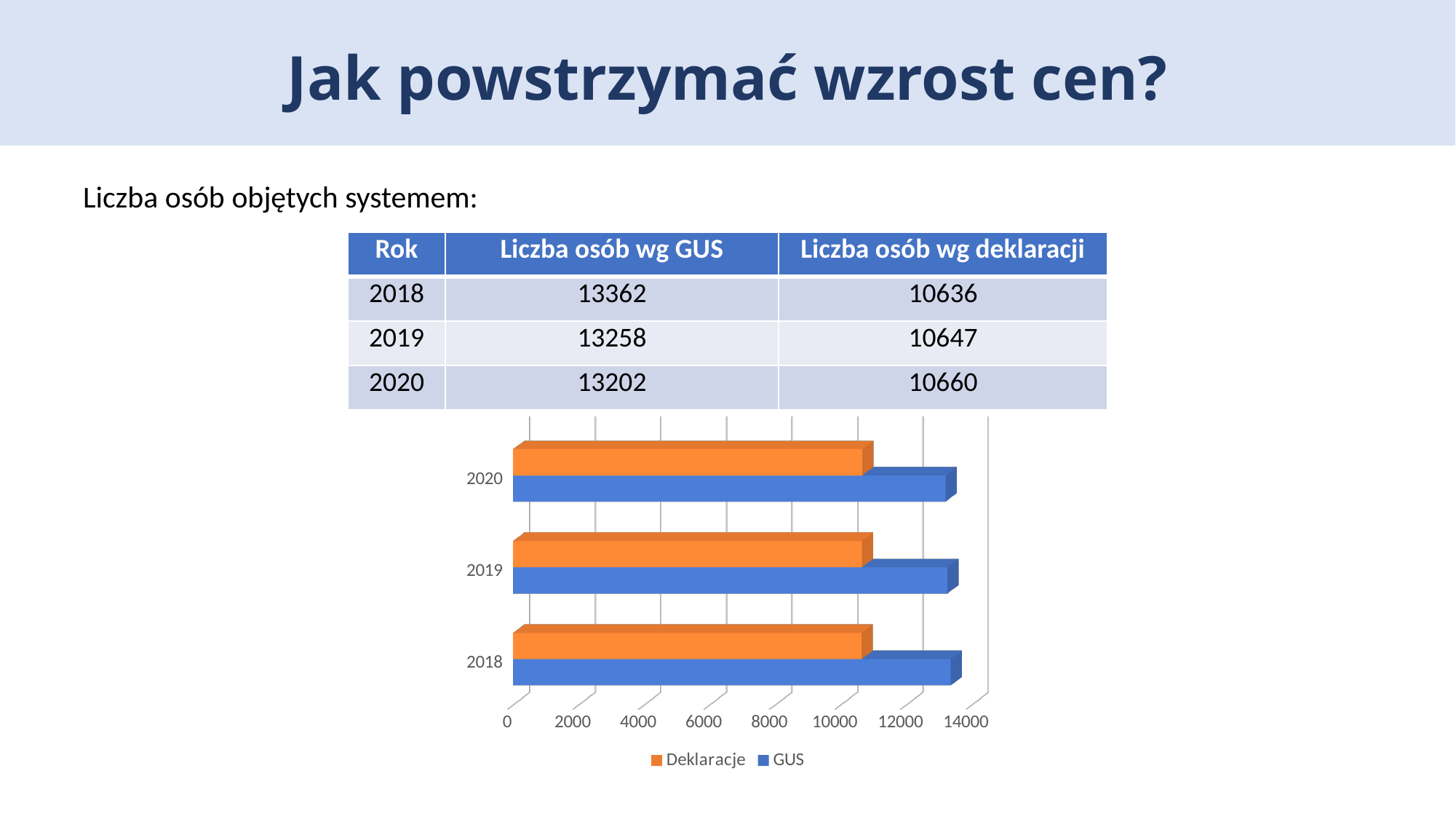
Is the Deklaracje value for 2019 greater or less than 10000? greater Is the Deklaracje value for 2020 greater or less than 12000? less What is the difference between the GUS value and the declarations value for 2018? 2726 How many years are shown on the chart's vertical axis? 3 How many series does the chart legend list? 2 According to the slide, what is the number of people according to declarations for 2020? 10660 Which series is shown in orange in the chart? Deklaracje What is the highest value on the axis of the chart? 14000 For 2019, which series has the larger value, GUS or Deklaracje? GUS Is the GUS value for 2018 greater or less than 12000? greater What kind of chart is shown on the slide? bar chart According to the slide, what is the number of people according to GUS for 2018? 13362